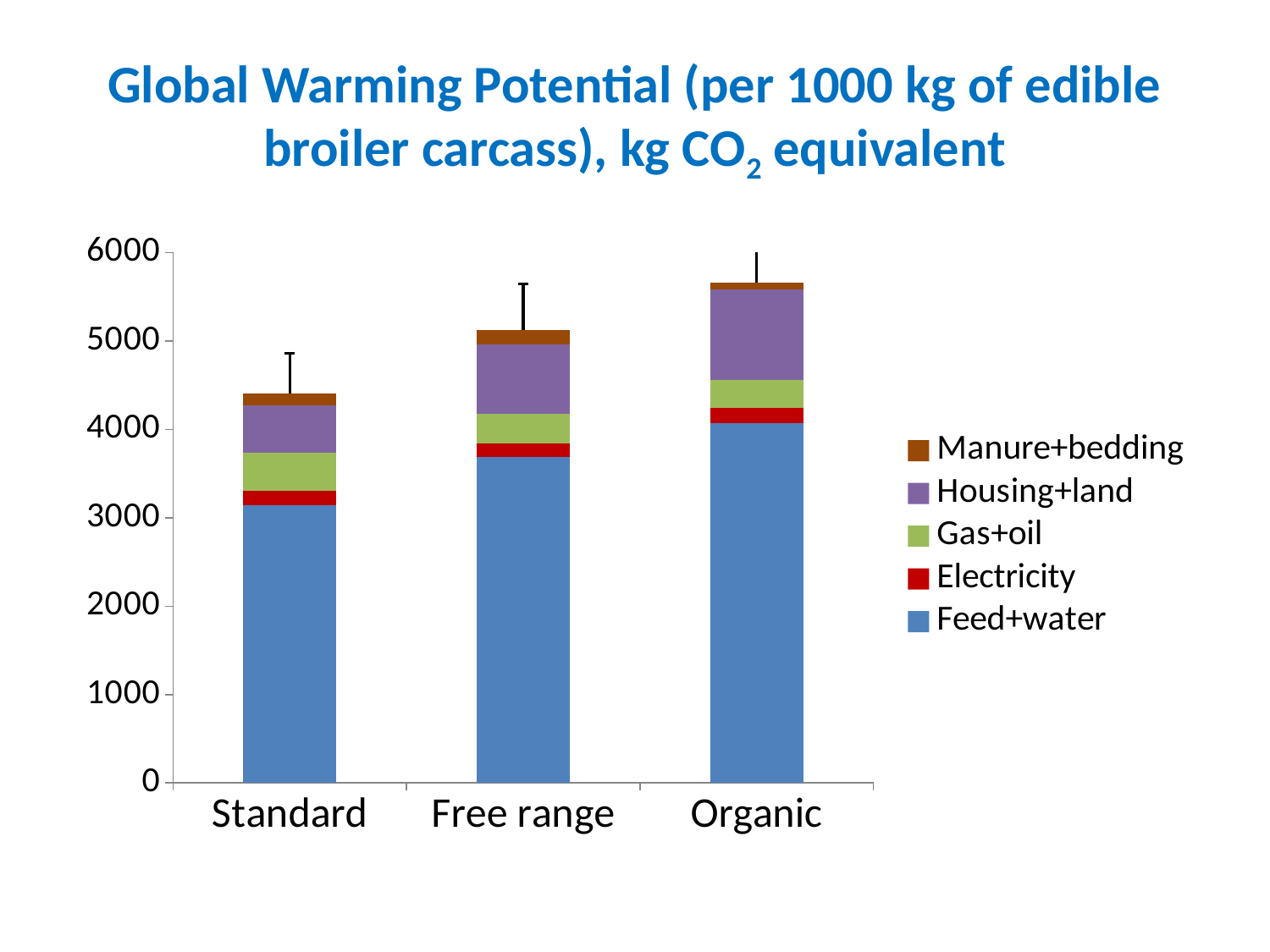
What kind of chart is shown on the slide? Stacked bar chart Which series contributes the largest share of each bar? Feed+water How many production systems (categories) are shown on the x axis? 3 Is the total value for Standard greater or less than 4000? greater Which production system has the lowest total global warming potential? Standard Which has a larger total global warming potential, Free range or Standard? Free range Is the Feed+water value for Free range greater or less than 4000? less Do the total bar heights rise or fall moving from Standard to Organic along the x axis? rise How many series does the legend list? 5 Which legend entry is shown in purple? Housing+land Is the total value for Organic greater or less than 6000? less Which production system has the highest total global warming potential? Organic